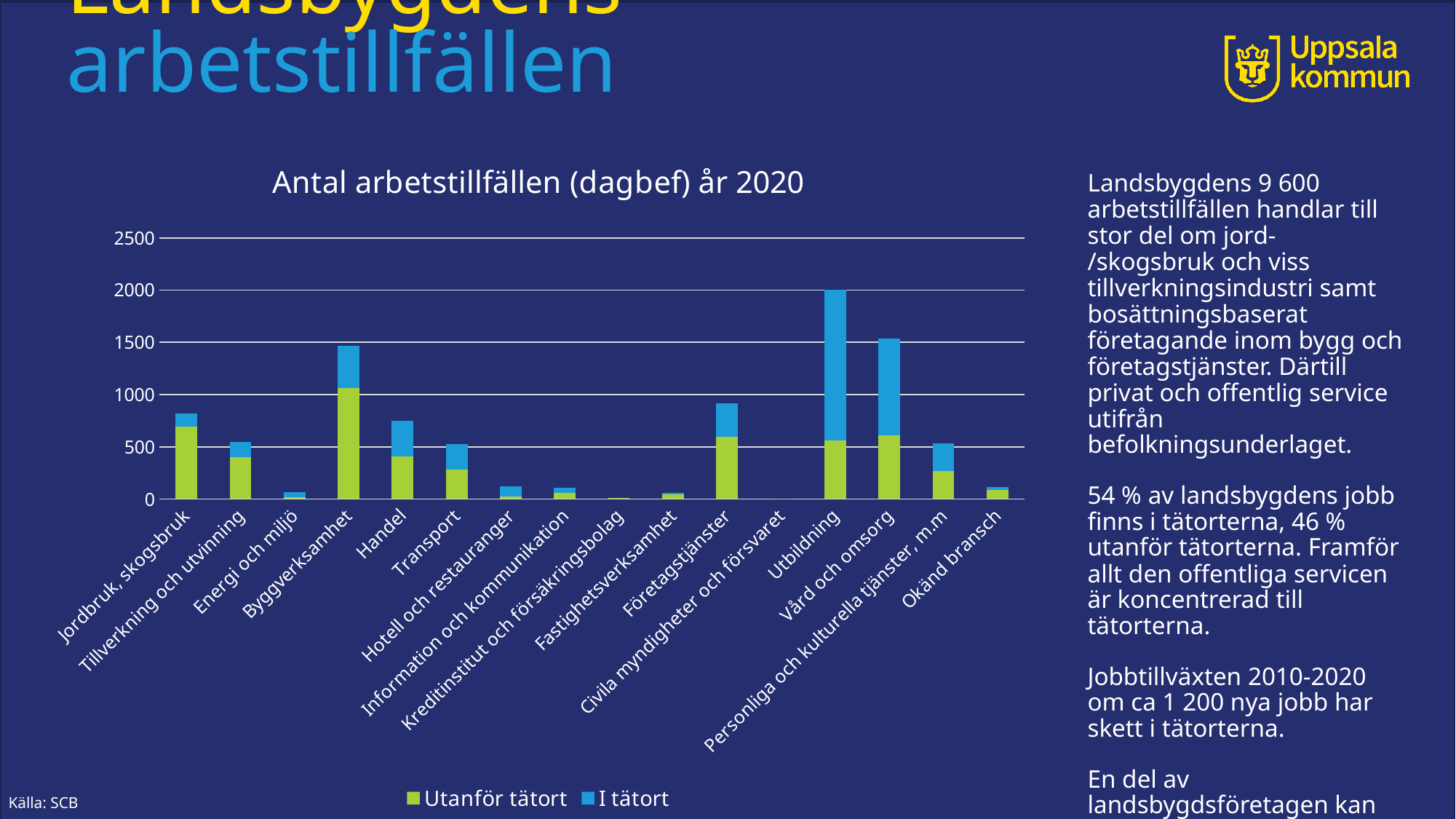
Is the total value for Jordbruk, skogsbruk greater or less than 1000? less How many series does the chart's legend list? 2 What is the title of the chart? Antal arbetstillfällen (dagbef) år 2020 Is the total value for Energi och miljö greater or less than 500? less What kind of chart is shown on the slide? Stacked bar chart Is the total value for Byggverksamhet greater or less than 1000? greater Which category has the highest total bar in the chart? Utbildning How many categories (branches) are shown on the x axis of the chart? 16 Which has a larger total bar, Byggverksamhet or Handel? Byggverksamhet Which has a larger total bar, Utbildning or Vård och omsorg? Utbildning Which series is shown in green in the chart? Utanför tätort